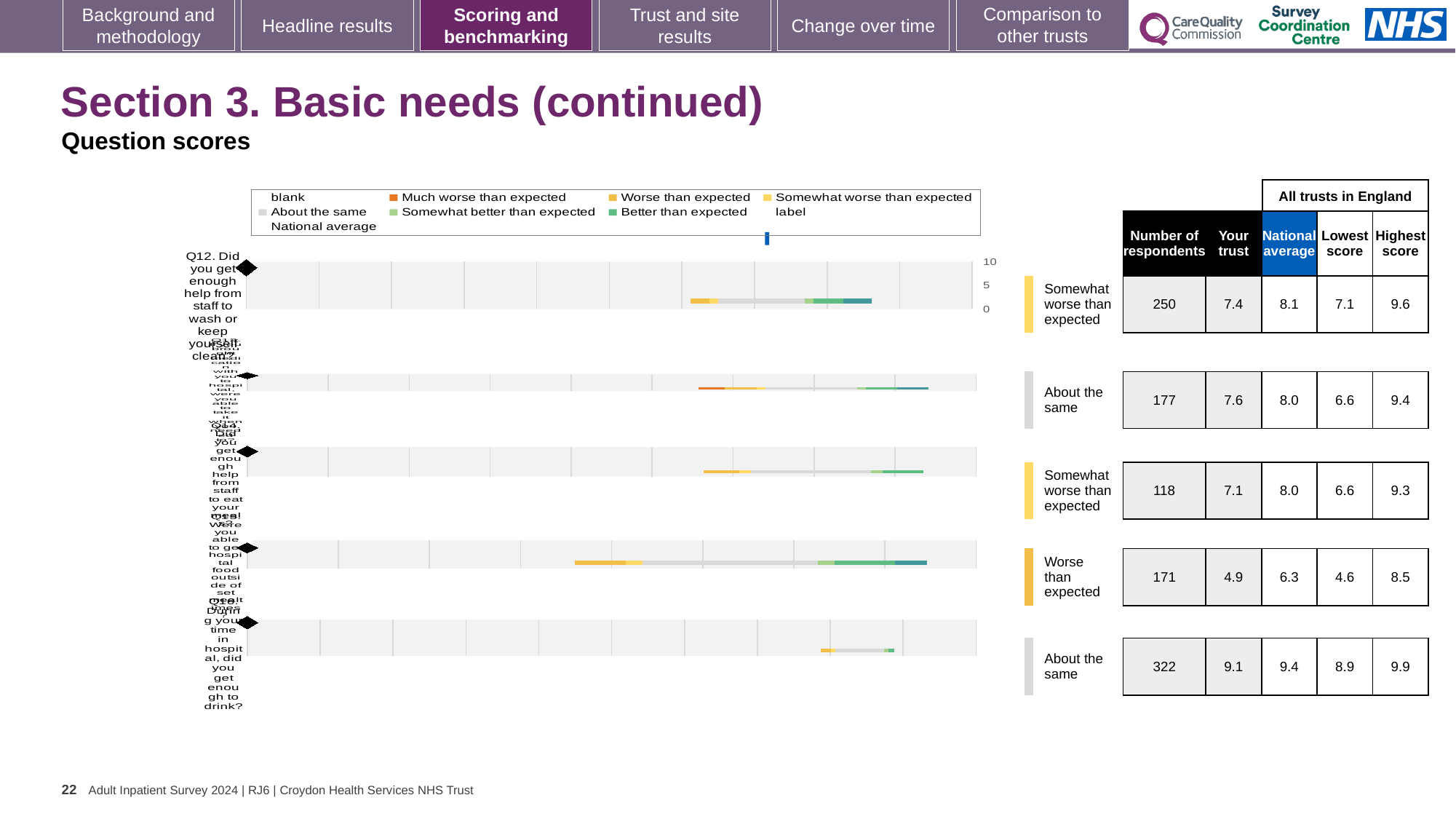
In the table next to the Q12 chart, what is the Your trust score? 7.4 What is the difference between the National average and the Your trust score for the Q15 row (fourth row)? 1.4 How many question charts (Q12 to Q16) are shown on the slide? 5 What is the highest tick value shown on the axis of the first (Q12) chart? 10 Which legend entry is shown in orange? Much worse than expected In the table next to the Q12 chart, what is the National average? 8.1 In the table next to the Q16 chart (fifth row), what is the Number of respondents? 322 In the table next to the Q15 chart (fourth row), what is the Your trust score? 4.9 What kind of chart is used for the question scores on this slide? bar chart How many entries does the chart legend list? 9 Which question row has the highest Your trust score in the table? Q16 (fifth row), 9.1 Which question row has the lowest Your trust score in the table? Q15 (fourth row), 4.9